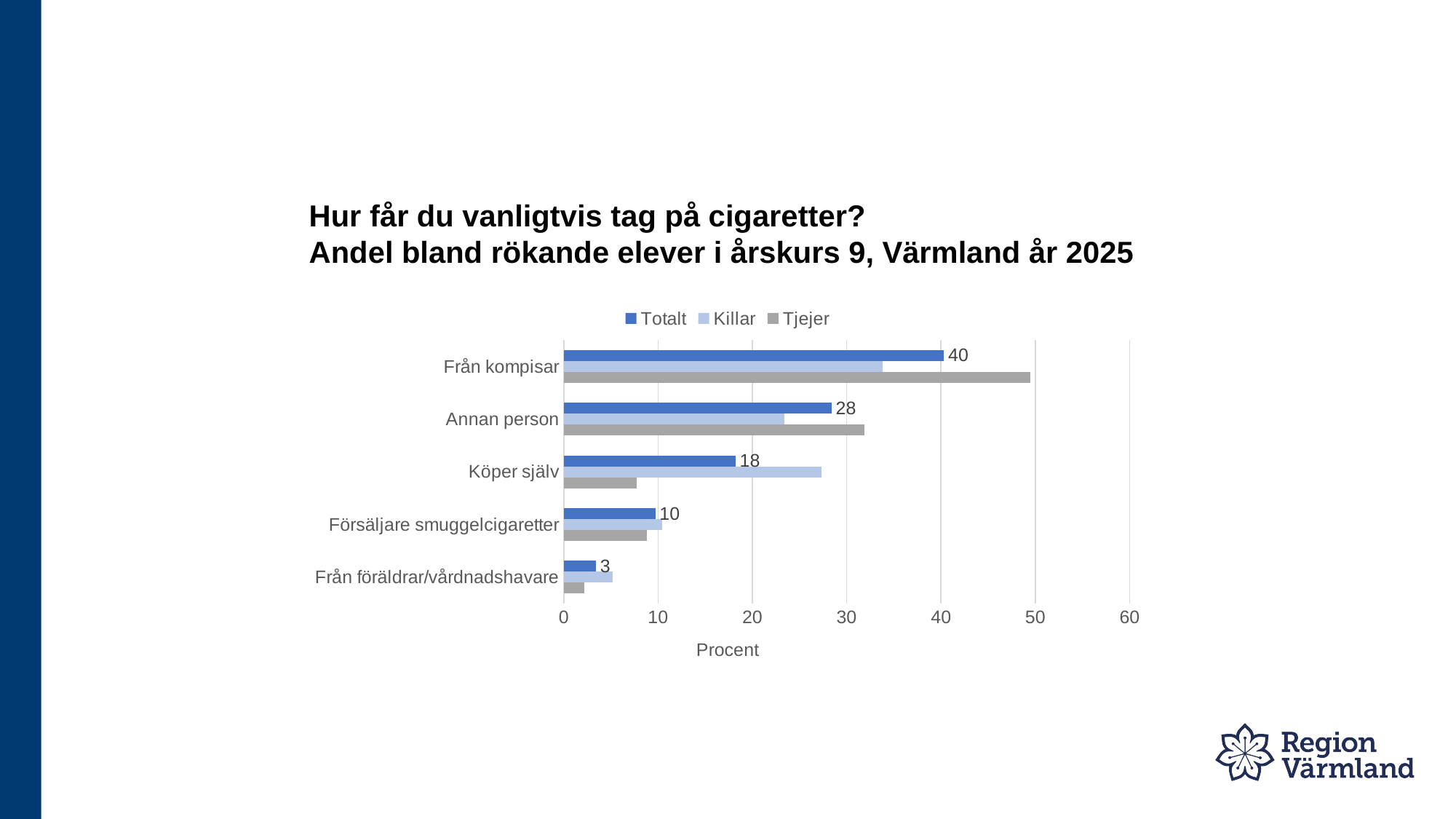
Is the Killar value for Annan person greater or less than 30? less Which category has the lowest Totalt value? Från föräldrar/vårdnadshavare For Köper själv, which is larger: the Killar value or the Tjejer value? Killar What kind of chart is shown on the slide? Bar chart How many categories are shown on the chart? 5 What is the Totalt value for Från föräldrar/vårdnadshavare? 3 What is the Totalt value for Köper själv? 18 What is the difference between the Totalt values for Från kompisar and Annan person? 12 Is the Tjejer value for Från kompisar greater or less than 40? greater What is the Totalt value for Från kompisar? 40 How many series does the legend list? 3 Which category has the highest Totalt value? Från kompisar